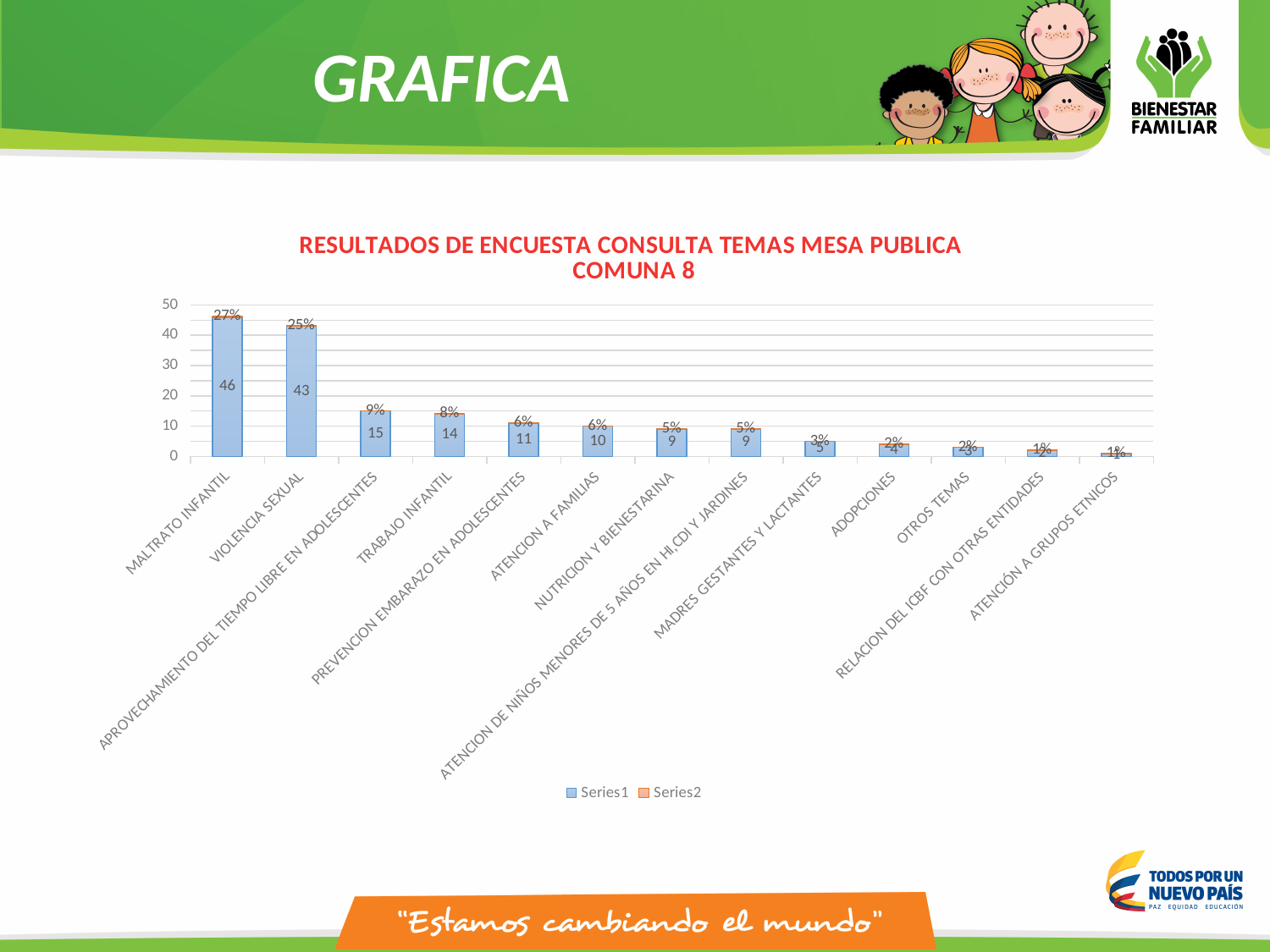
Which has a larger Series1 value, APROVECHAMIENTO DEL TIEMPO LIBRE EN ADOLESCENTES or ADOPCIONES? APROVECHAMIENTO DEL TIEMPO LIBRE EN ADOLESCENTES What is the title of the chart? RESULTADOS DE ENCUESTA CONSULTA TEMAS MESA PUBLICA COMUNA 8 Which category has the highest Series1 value? MALTRATO INFANTIL Which category has the lowest Series1 value? ATENCIÓN A GRUPOS ETNICOS What is the Series1 value for MALTRATO INFANTIL? 46 What type of chart is shown on the slide? bar chart How many categories are shown on the x axis? 13 How many series does the legend list? 2 What is the Series1 value for VIOLENCIA SEXUAL? 43 Do the Series1 values generally rise or fall from left to right along the x axis? fall What is the difference between the Series1 values for MALTRATO INFANTIL and VIOLENCIA SEXUAL? 3 What percentage label is shown for TRABAJO INFANTIL? 8%